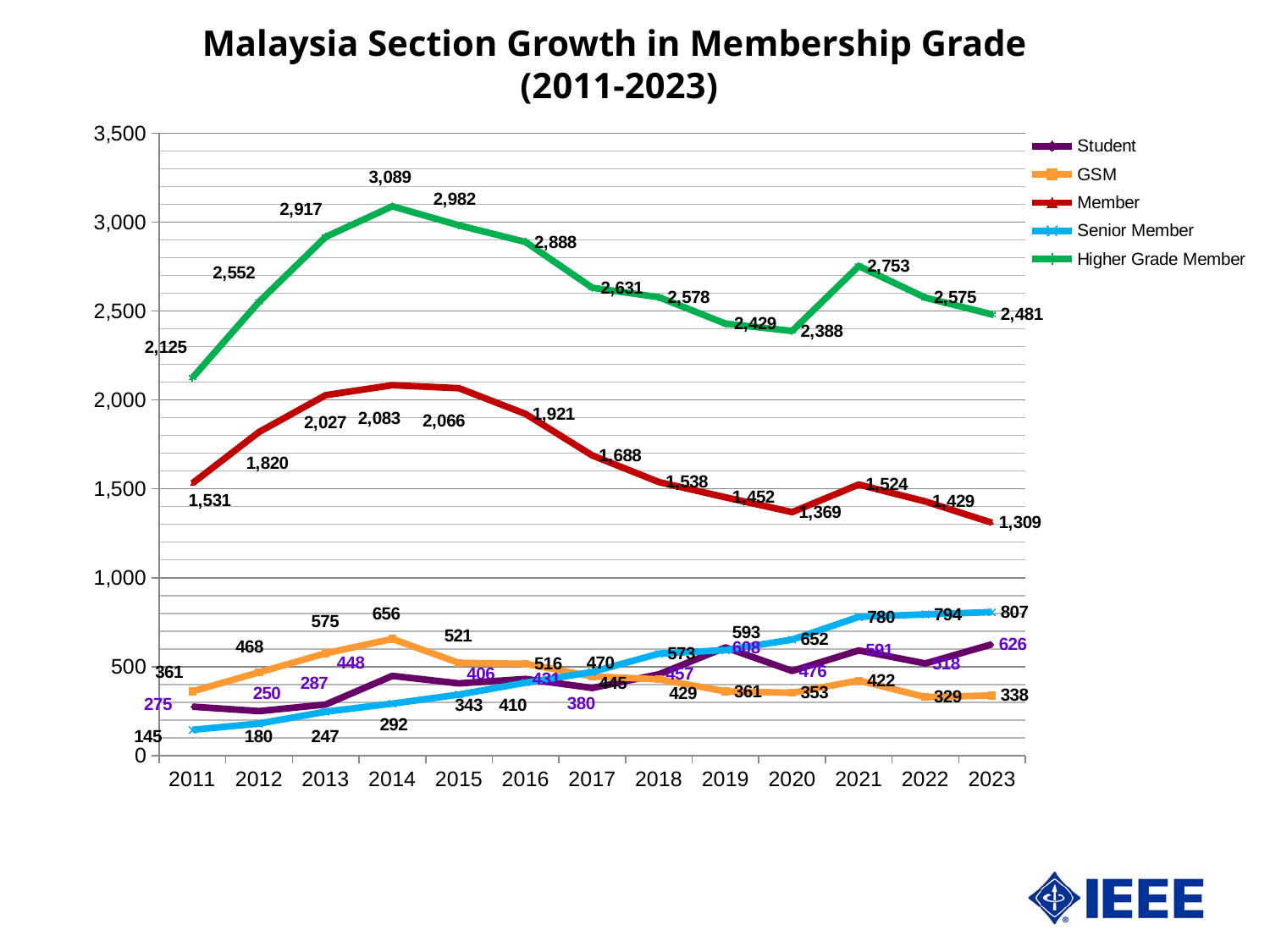
What was the GSM value in 2014? 656 How many series does the legend list? 5 In which year was the Member series at its lowest? 2023 How many years are plotted along the x axis? 13 What type of chart is shown on the slide? Line chart Does the Senior Member series generally rise or fall from 2011 to 2023? Rise What was the Senior Member value in 2023? 807 In which year did the Higher Grade Member series reach its highest value? 2014 What is the difference between the Member value in 2011 and in 2023? 222 In 2023, which is larger: Senior Member or Student? Senior Member What was the Member value in 2023? 1,309 What was the Higher Grade Member value in 2014? 3,089